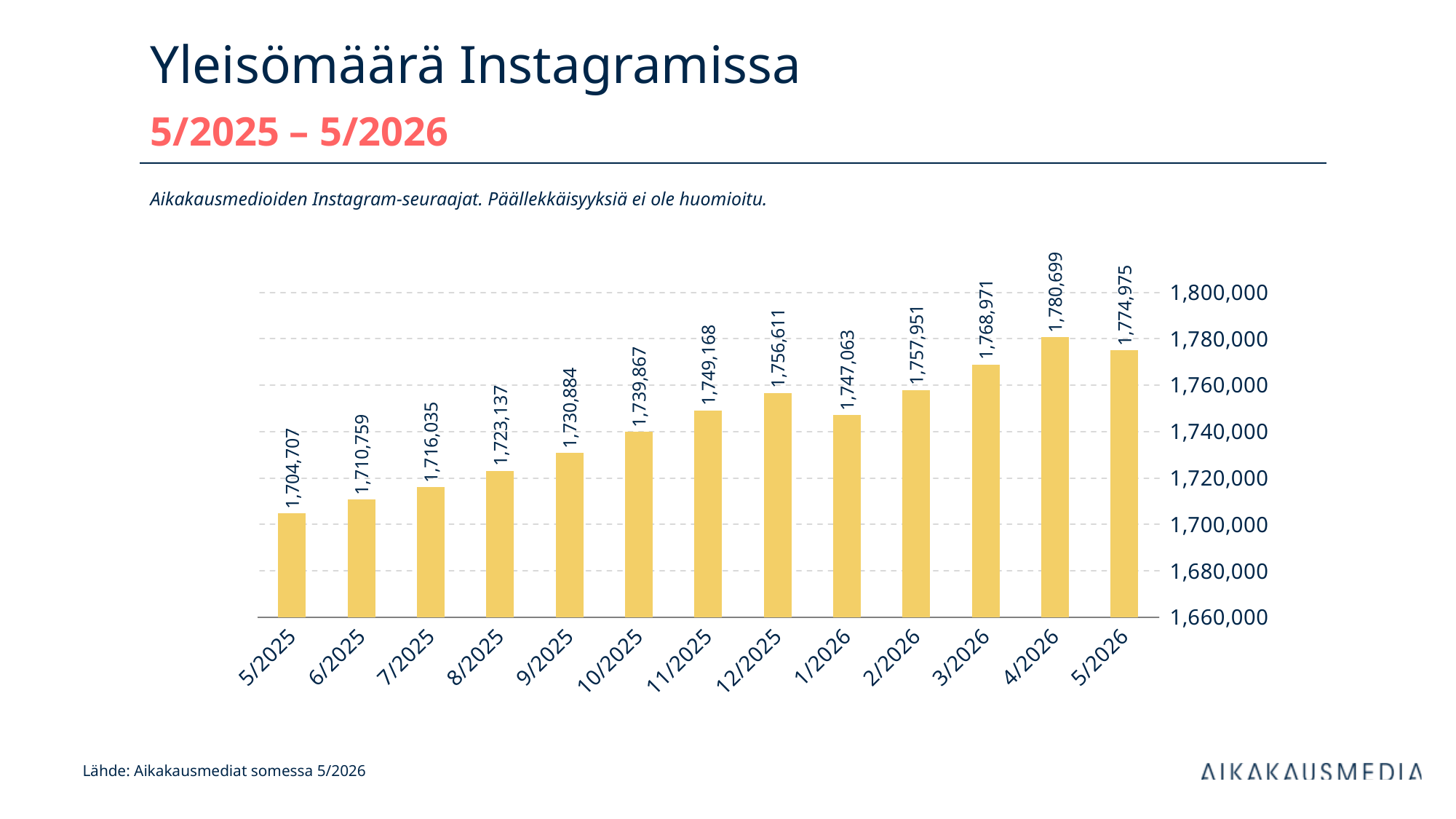
What is the value for 5/2025? 1,704,707 How many months are shown on the x axis? 13 Is the value for 10/2025 greater or less than 1,720,000? greater What is the value for 5/2026? 1,774,975 Which month has the lowest value? 5/2025 What kind of chart is shown on the slide? bar chart Which month has the highest value? 4/2026 What is the difference between the values for 5/2026 and 5/2025? 70,268 Which is larger, the value for 12/2025 or the value for 1/2026? 12/2025 What is the difference between the values for 4/2026 and 5/2026? 5,724 What is the value for 1/2026? 1,747,063 What is the title of the chart on the slide? Yleisömäärä Instagramissa